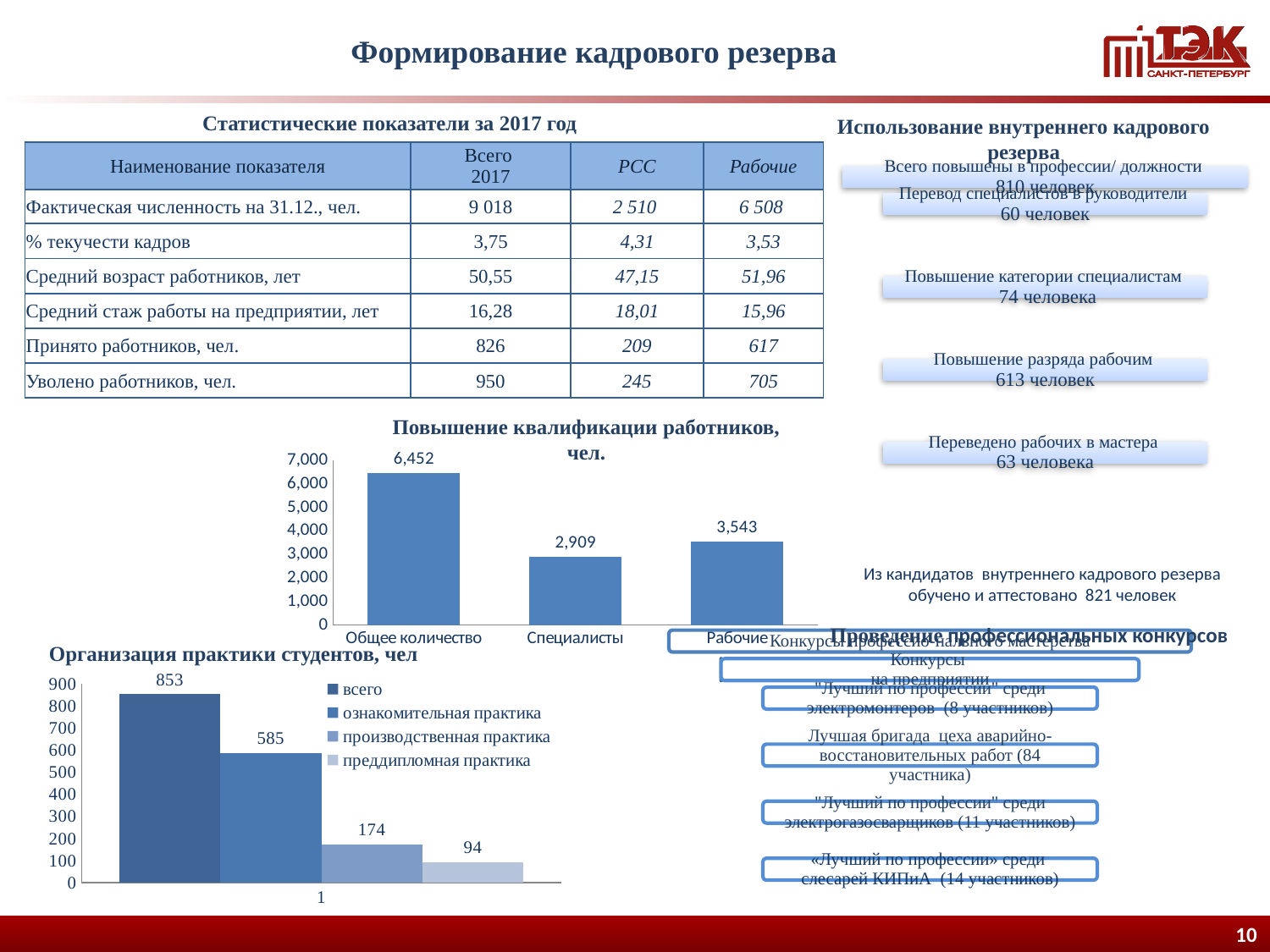
In the chart 'Организация практики студентов, чел', how many series does the legend list? 4 What type of chart is 'Организация практики студентов, чел'? Bar chart In the chart 'Повышение квалификации работников, чел.', which category has the lowest value? Специалисты In the chart 'Повышение квалификации работников, чел.', what is the value for Общее количество? 6,452 In the chart 'Повышение квалификации работников, чел.', how many categories are shown on the x axis? 3 In the chart 'Организация практики студентов, чел', which is larger: производственная практика or преддипломная практика? производственная практика In the chart 'Повышение квалификации работников, чел.', what is the difference between Рабочие and Специалисты? 634 In the chart 'Повышение квалификации работников, чел.', what is the value for Рабочие? 3,543 In the chart 'Организация практики студентов, чел', what is the value for преддипломная практика? 94 In the chart 'Организация практики студентов, чел', what is the difference between всего and ознакомительная практика? 268 In the chart 'Повышение квалификации работников, чел.', what is the value for Специалисты? 2,909 In the chart 'Организация практики студентов, чел', what is the value for ознакомительная практика? 585